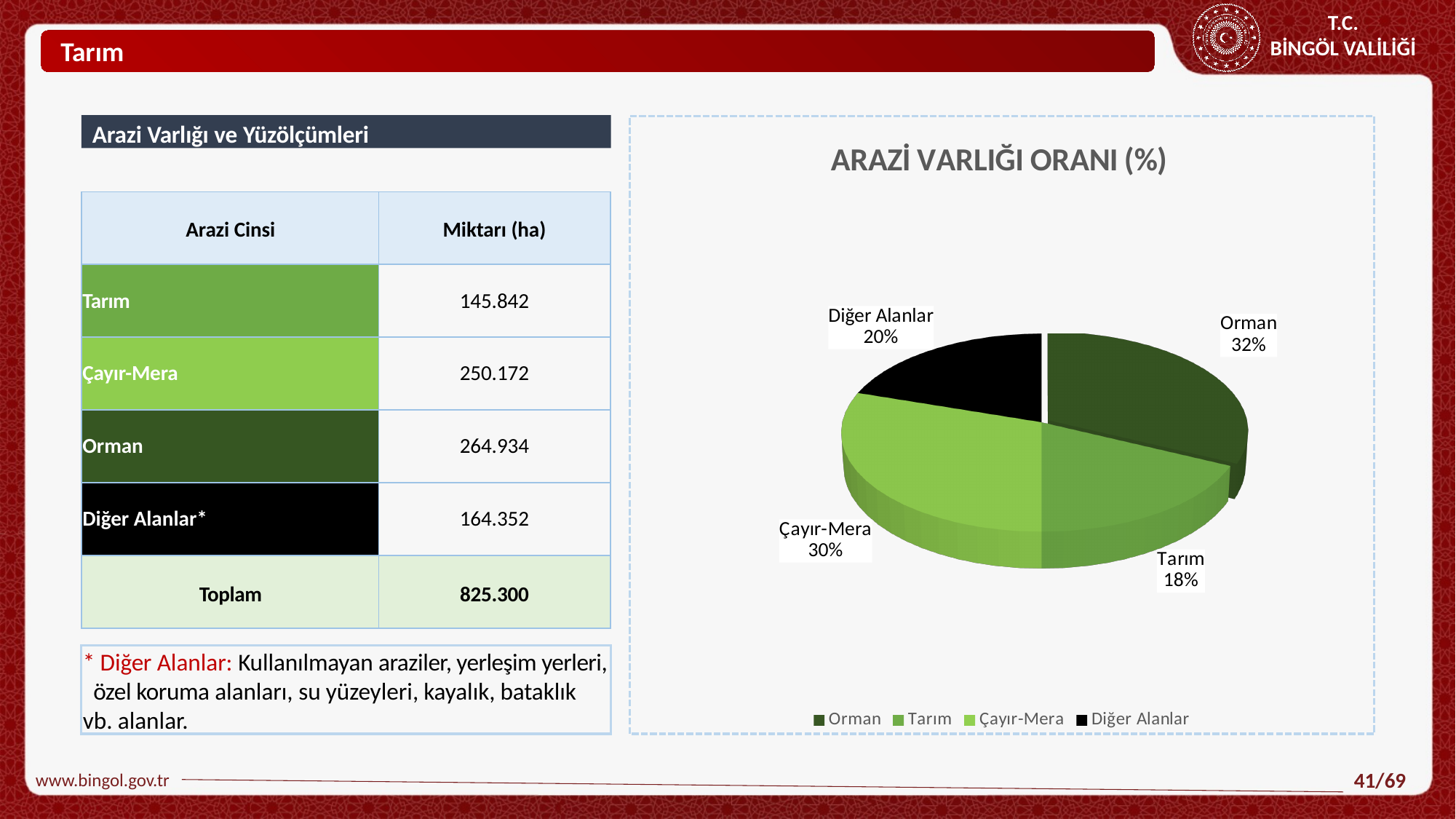
How many entries does the legend list? 4 What share of the pie does Diğer Alanlar have? 20% What share of the pie does Tarım have? 18% What is the title of the chart? ARAZİ VARLIĞI ORANI (%) How many slices does the pie chart have? 4 What kind of chart is shown on the slide? pie chart Which category has the largest slice of the pie? Orman Which category has the smallest slice of the pie? Tarım What share of the pie does Orman have? 32% What is the difference in percentage points between Orman and Tarım? 14 Which is larger, the share for Diğer Alanlar or the share for Çayır-Mera? Çayır-Mera